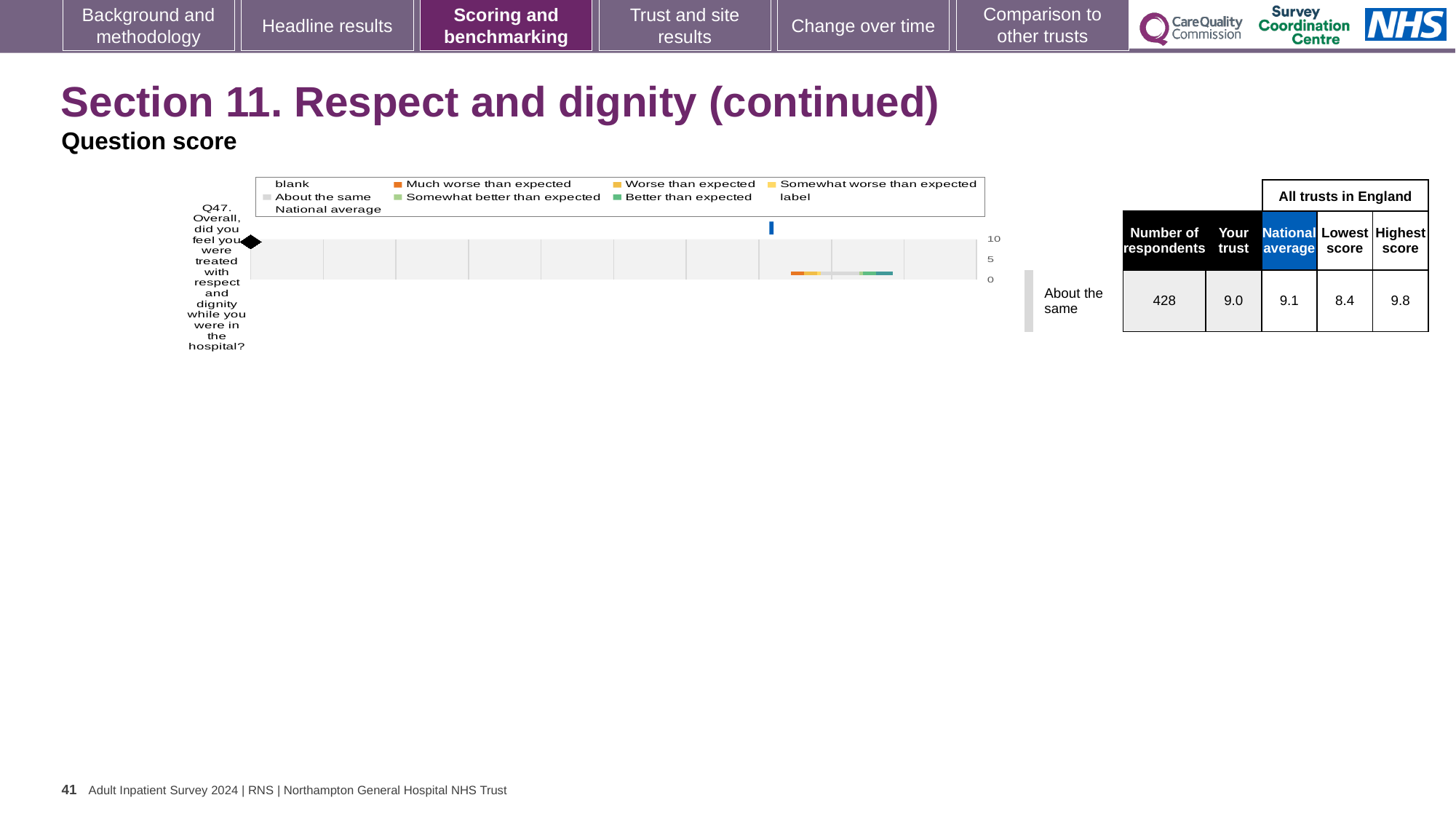
Which question is plotted on the chart? Q47. Overall, did you feel you were treated with respect and dignity while you were in the hospital? What is the 'Your trust' score for Q47? 9.0 What is the national average score for Q47? 9.1 What is the lowest score among all trusts in England for Q47? 8.4 How many respondents answered Q47? 428 Which is larger for Q47, the trust score or the national average? national average What is the benchmark category shown for Q47? About the same What is the highest score among all trusts in England for Q47? 9.8 What is the maximum value shown on the chart's numeric axis? 10 How many questions (categories) are plotted on the chart? 1 What is the difference between the highest and lowest scores for Q47 across all trusts in England? 1.4 What kind of chart is shown on the slide? bar chart